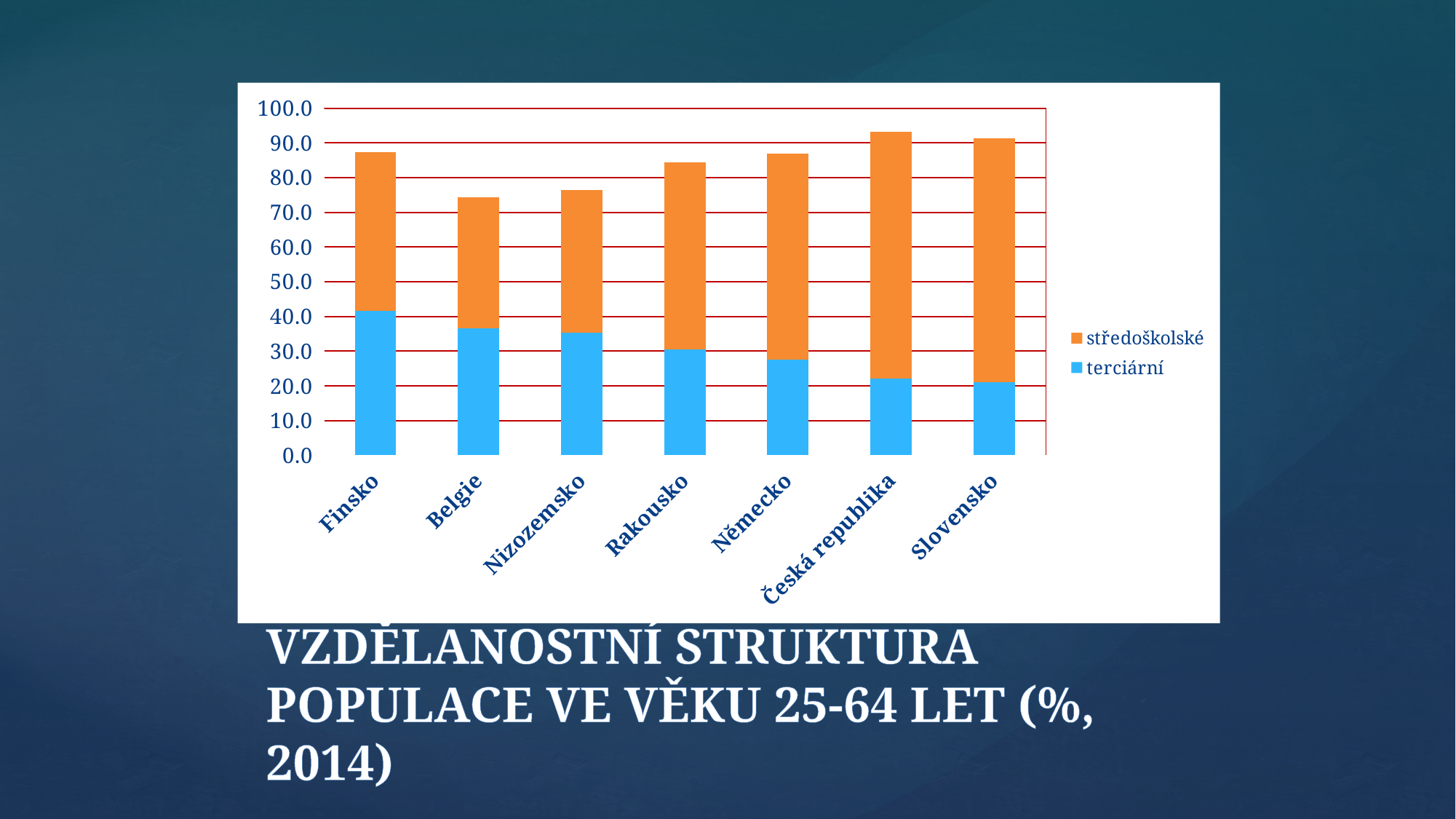
Which is larger, the terciární value for Finsko or for Belgie? Finsko Is the total stacked bar for Rakousko greater or less than 80? greater Is the terciární value for Německo greater or less than 30? less Is the total stacked bar for Česká republika greater or less than 90? greater What kind of chart is shown on the slide? stacked bar chart Which colour represents the středoškolské series in the chart? orange How many series does the legend list? 2 Do the terciární values rise or fall moving from Finsko to Slovensko along the x axis? fall Which country has the highest value for terciární? Finsko How many countries are shown on the x axis of the chart? 7